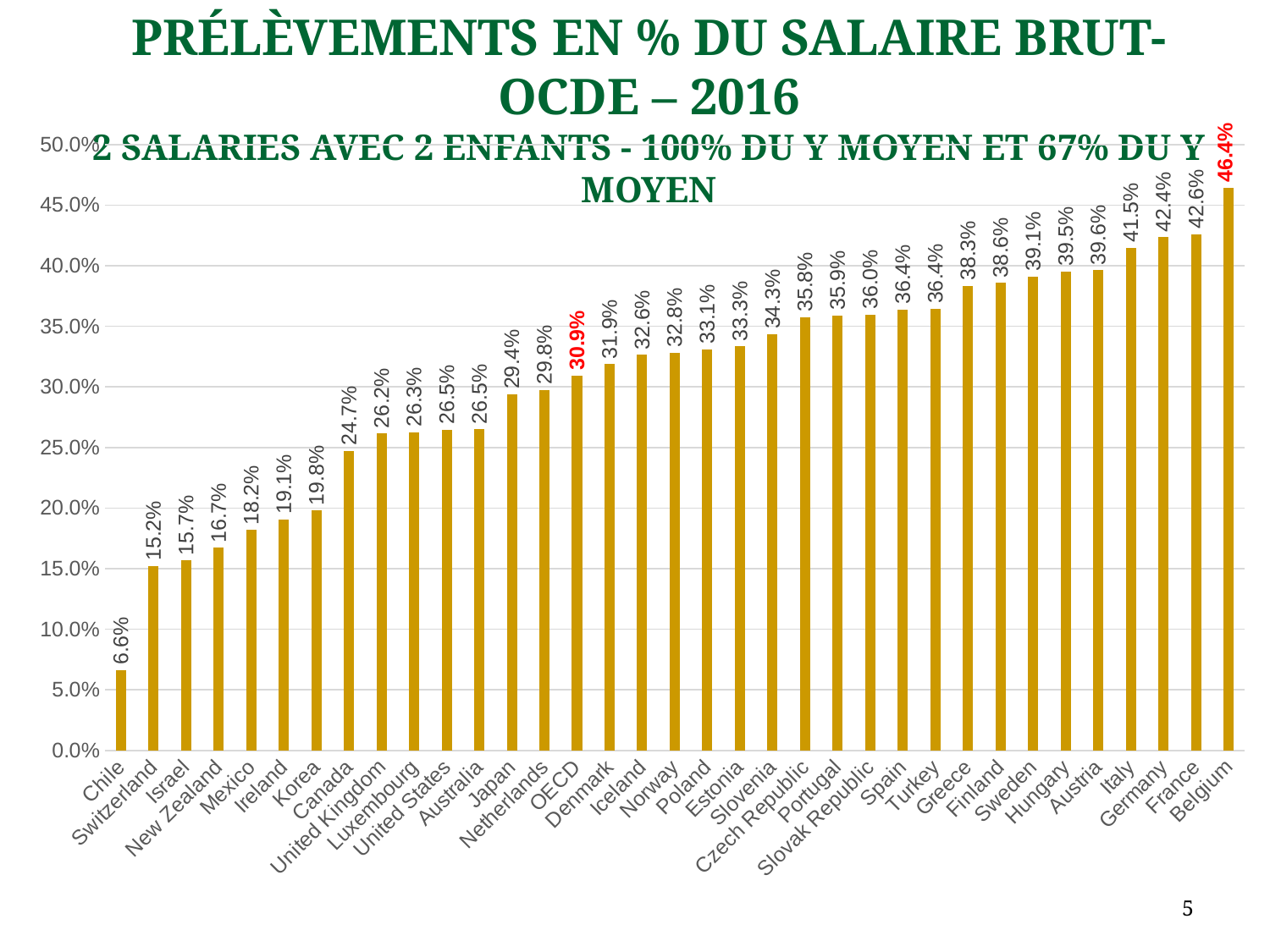
What is the difference between the values for Germany and the OECD? 11.5% Is the value for Italy greater or less than 40.0%? greater Which is larger, the value for Japan or the value for Canada? Japan What is the value for the OECD bar? 30.9% What kind of chart is shown on the slide? bar chart What is the difference between the values for Belgium and Chile? 39.8% What is the value for Mexico? 18.2% Do the values rise or fall from left to right along the x axis? rise What is the value for France? 42.6% Which country has the lowest value? Chile How many bars are shown in the chart? 35 Which country has the highest value? Belgium